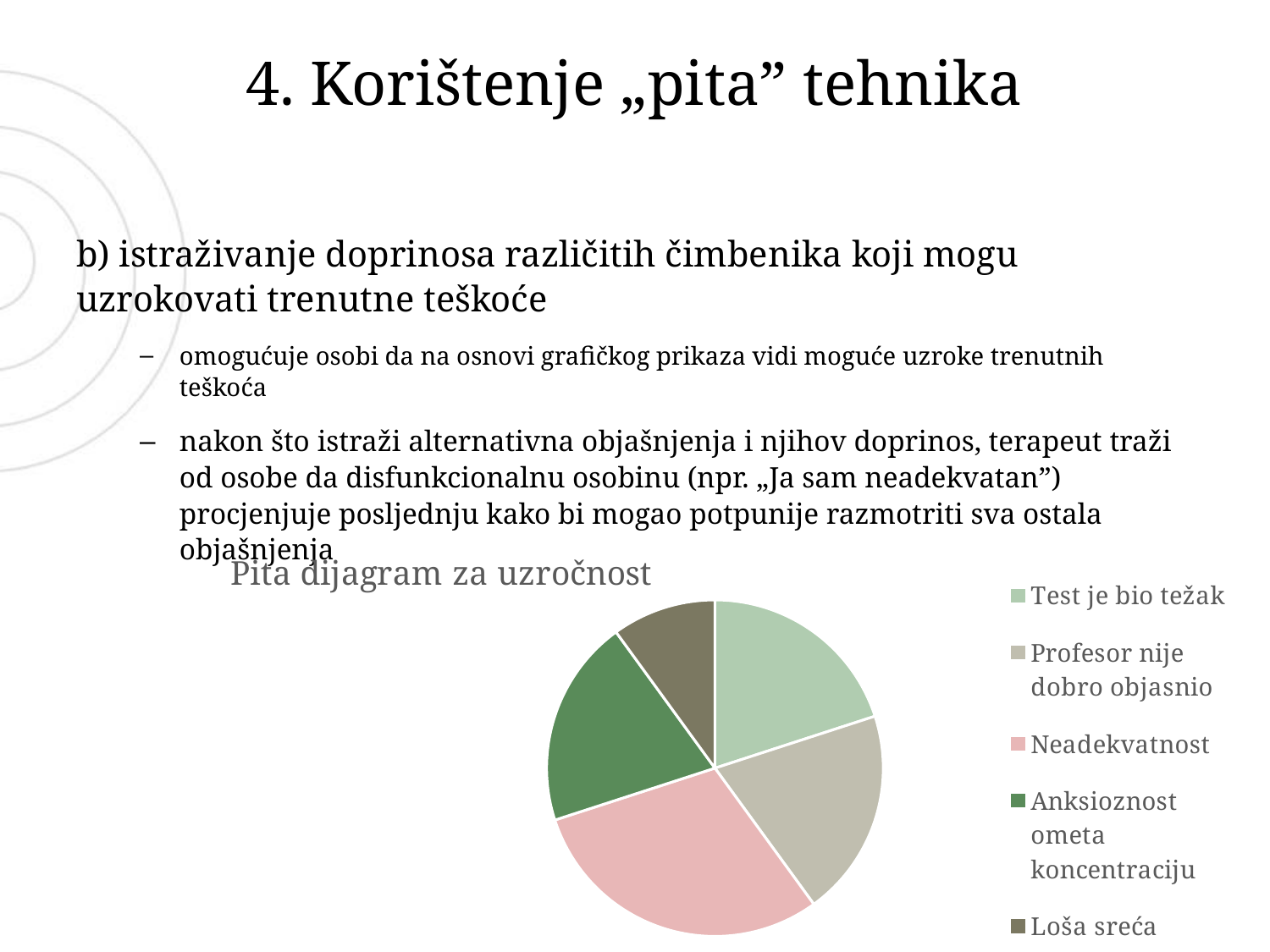
How many entries does the chart legend list? 5 Which slice is larger, Neadekvatnost or Anksioznost ometa koncentraciju? Neadekvatnost What is the title of the chart? Pita dijagram za uzročnost What colour is the slice for Neadekvatnost? pink What kind of chart is shown on the slide? pie chart Which slice is larger, Neadekvatnost or Loša sreća? Neadekvatnost How many slices does the pie chart have? 5 Which category has the smallest slice of the pie? Loša sreća Which slice is larger, Test je bio težak or Loša sreća? Test je bio težak Which category has the largest slice of the pie? Neadekvatnost